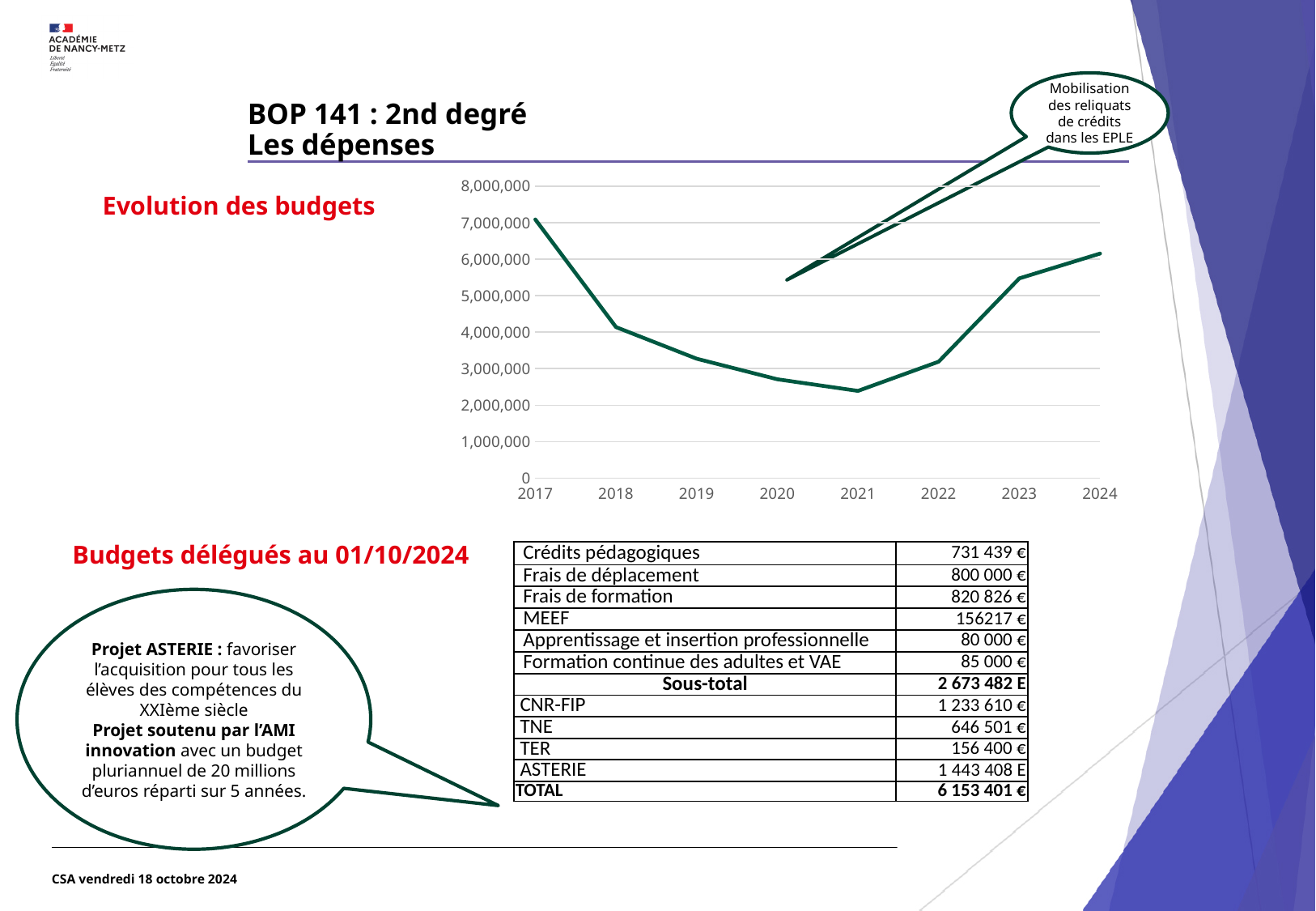
In the 'Evolution des budgets' chart, is the value for 2018 greater or less than 5,000,000? less How many years are plotted on the x axis of the 'Evolution des budgets' chart? 8 What kind of chart is shown under 'Evolution des budgets'? line chart In the 'Evolution des budgets' chart, is the value for 2023 greater or less than 5,000,000? greater In the 'Evolution des budgets' chart, which year has the highest value? 2017 In the 'Evolution des budgets' chart, do the values rise or fall from 2017 to 2021? fall In the 'Evolution des budgets' chart, is the value for 2024 greater or less than 6,000,000? greater In the 'Evolution des budgets' chart, which year has the lowest value? 2021 In the 'Evolution des budgets' chart, do the values rise or fall from 2021 to 2024? rise In the 'Evolution des budgets' chart, which year has the larger value, 2017 or 2024? 2017